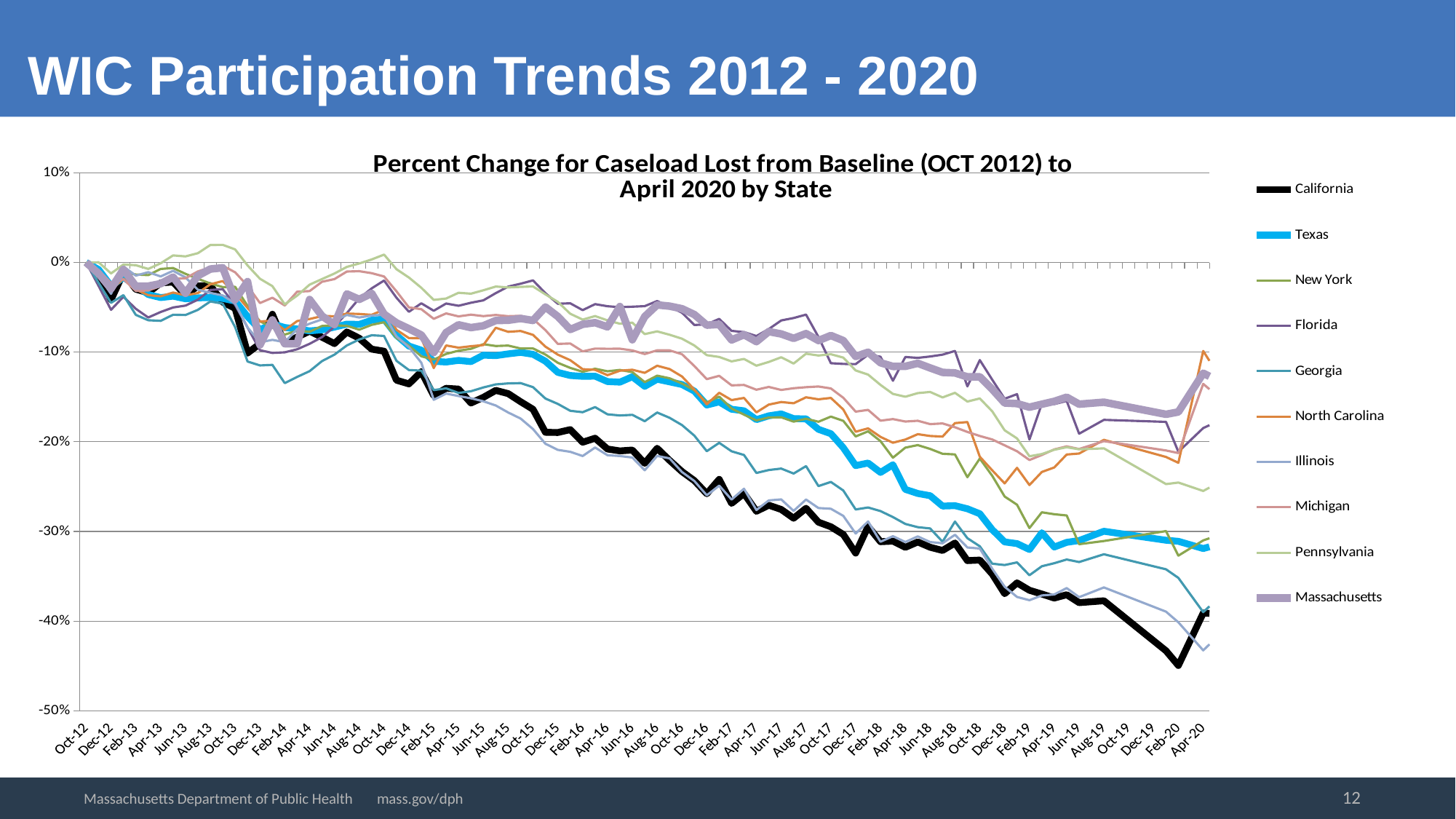
Is the value for Massachusetts at Apr-20 greater or less than -20%? greater Which state is listed last in the legend? Massachusetts At Apr-20, which is larger, the value for Florida or the value for Georgia? Florida Which state has the lowest value at Feb-20? California Is the value for Pennsylvania at Apr-20 greater or less than -30%? greater Overall, do the lines rise or fall from Oct-12 to Apr-20? fall Is the value for California at Feb-20 greater or less than -40%? less What is the title of the chart? Percent Change for Caseload Lost from Baseline (OCT 2012) to April 2020 by State How many states (series) does the legend list? 10 At Apr-20, which is larger, the value for Massachusetts or the value for California? Massachusetts What kind of chart is shown on the slide? line chart